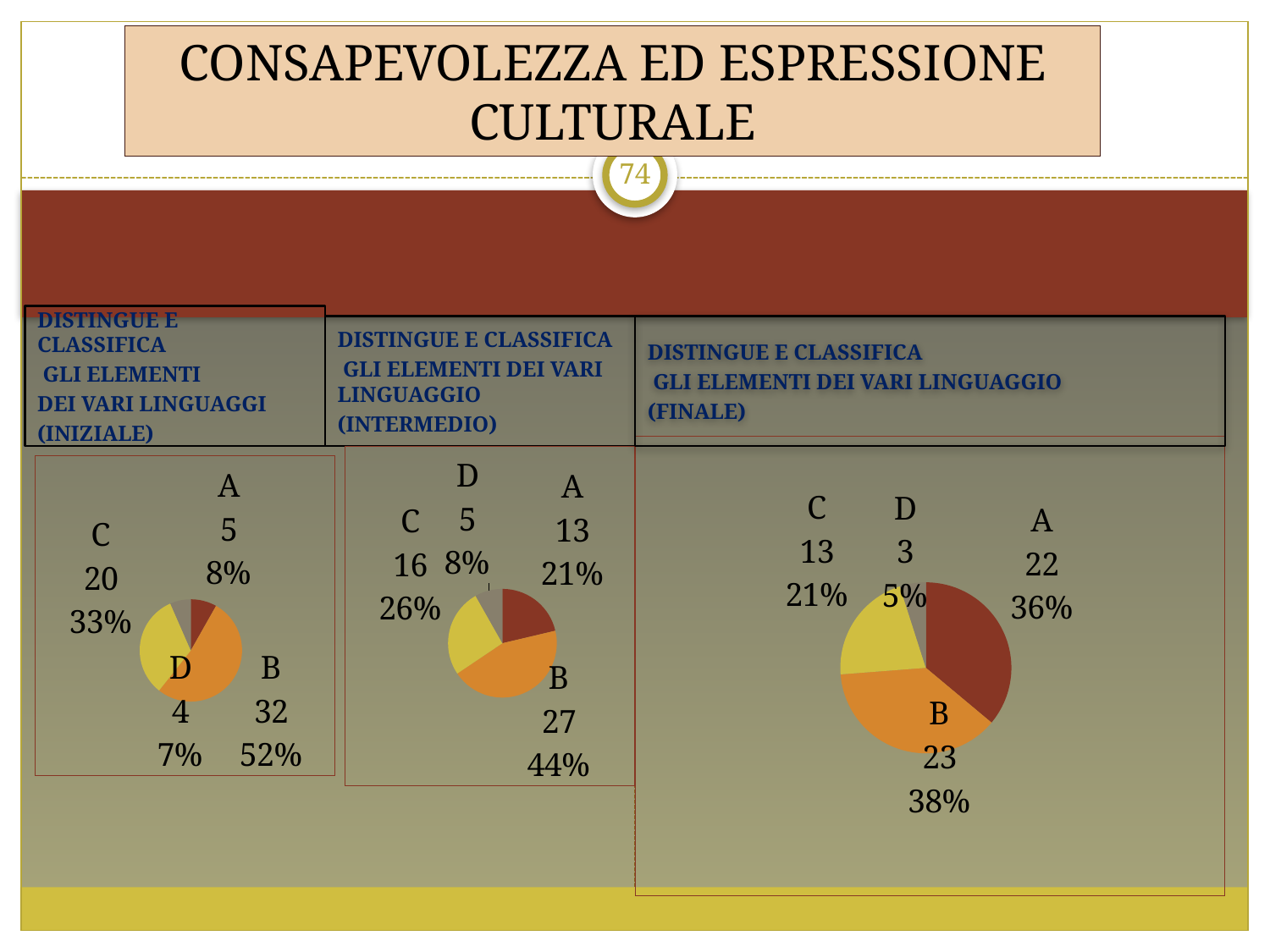
In the INTERMEDIO pie chart (middle), which category has the largest value? B In the INIZIALE pie chart (left), what is the difference between the values for B and A? 27 In the INTERMEDIO pie chart (middle), what is the difference between the values for B and C? 11 How many categories does the FINALE pie chart (right) show? 4 What type of chart is used in the INIZIALE panel (left)? Pie chart In the INIZIALE pie chart (left), which category has the smallest value? D In the FINALE pie chart (right), which is larger, the value for A or the value for C? A In the INTERMEDIO pie chart (middle), what is the value for category A? 13 In the FINALE pie chart (right), what percentage share does category A have? 36% In the FINALE pie chart (right), what is the value for category D? 3 In the INIZIALE pie chart (left), what percentage share does category C have? 33% In the INIZIALE pie chart (left), what is the value for category B? 32